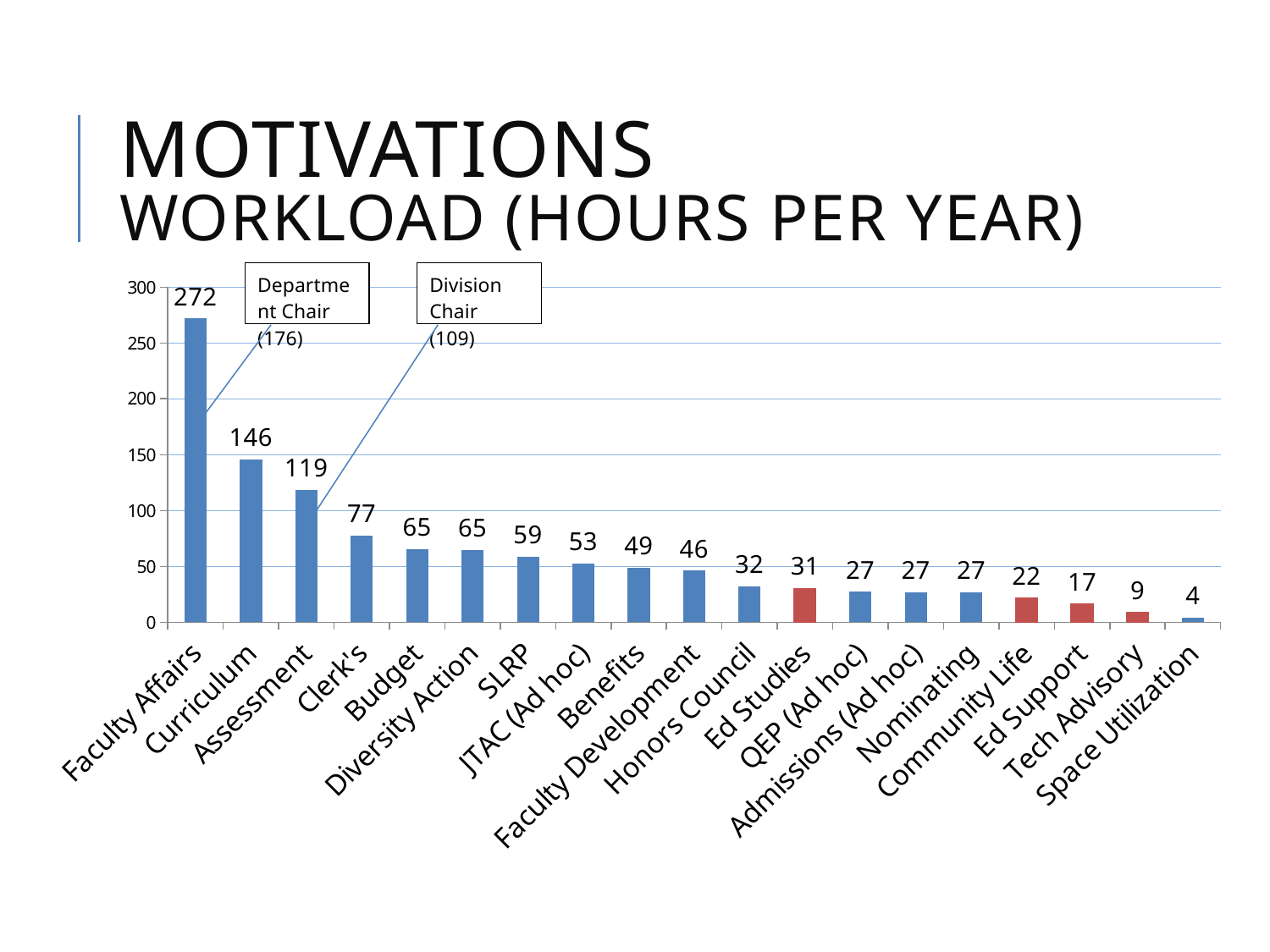
What is the value for Assessment? 119 Is the value for Honors Council greater or less than 50? less What kind of chart is shown on the slide? bar chart Which is larger, the value for Clerk's or the value for SLRP? Clerk's What is the value for Space Utilization? 4 Which category has the lowest value? Space Utilization What is the value for Faculty Affairs? 272 Which category has the highest value? Faculty Affairs How many categories are shown on the x axis? 19 What is the value for JTAC (Ad hoc)? 53 What value is given for Department Chair in the annotation box? 176 What is the difference between the values for Faculty Affairs and Curriculum? 126